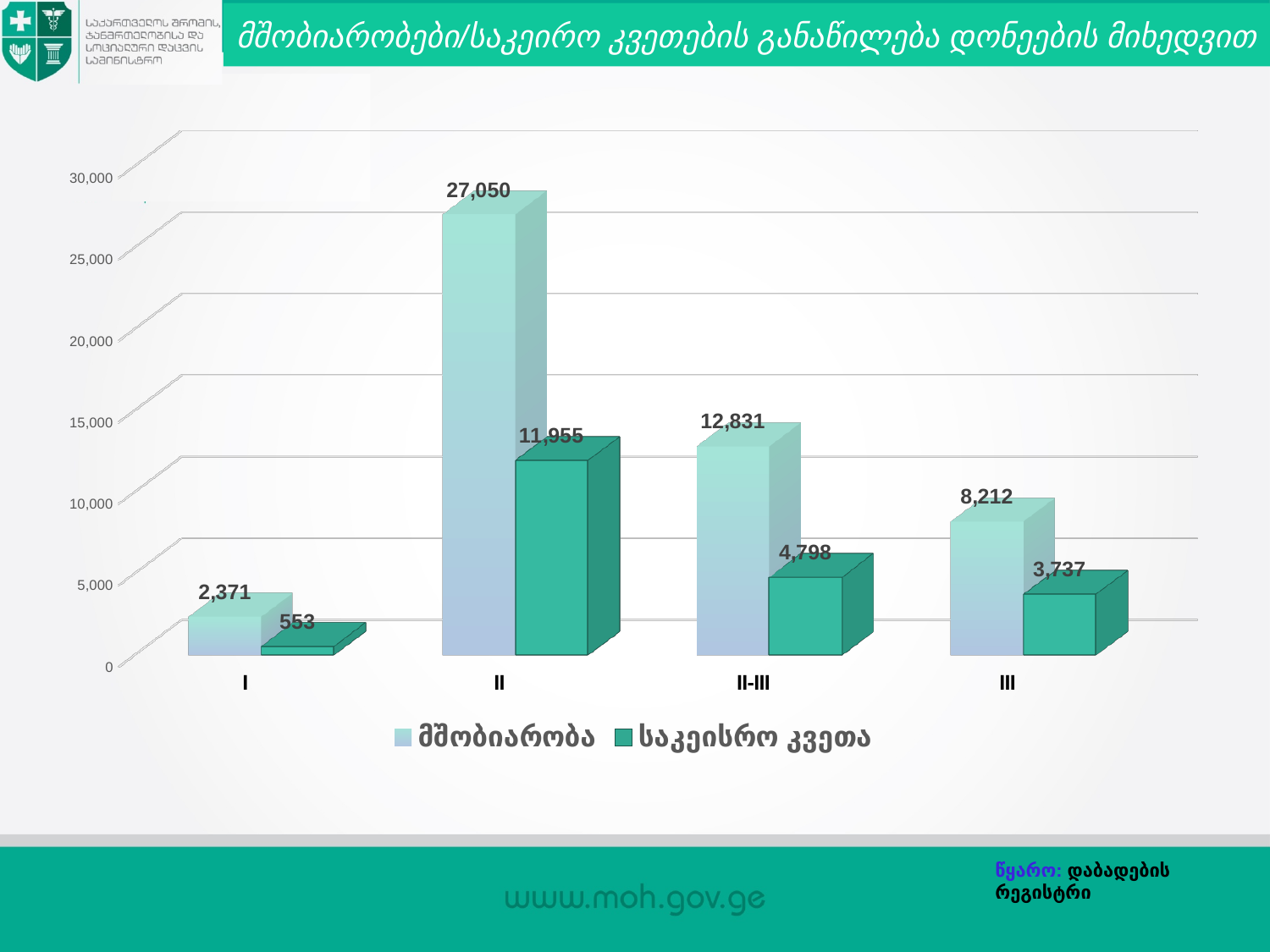
What is the value for საკეისრო კვეთა at level I? 553 How many series does the legend list? 2 What is the difference between მშობიარობა and საკეისრო კვეთა at level II? 15,095 How many levels (categories) are shown on the x axis? 4 Which level has the lowest value for საკეისრო კვეთა? I What is the value for მშობიარობა at level III? 8,212 Which level has the highest value for მშობიარობა? II What kind of chart is shown on the slide? Bar chart Which is larger: საკეისრო კვეთა at level II-III or at level III? II-III What is the value for მშობიარობა at level II? 27,050 What is the difference between მშობიარობა at level II-III and at level III? 4,619 What is the value for საკეისრო კვეთა at level II-III? 4,798